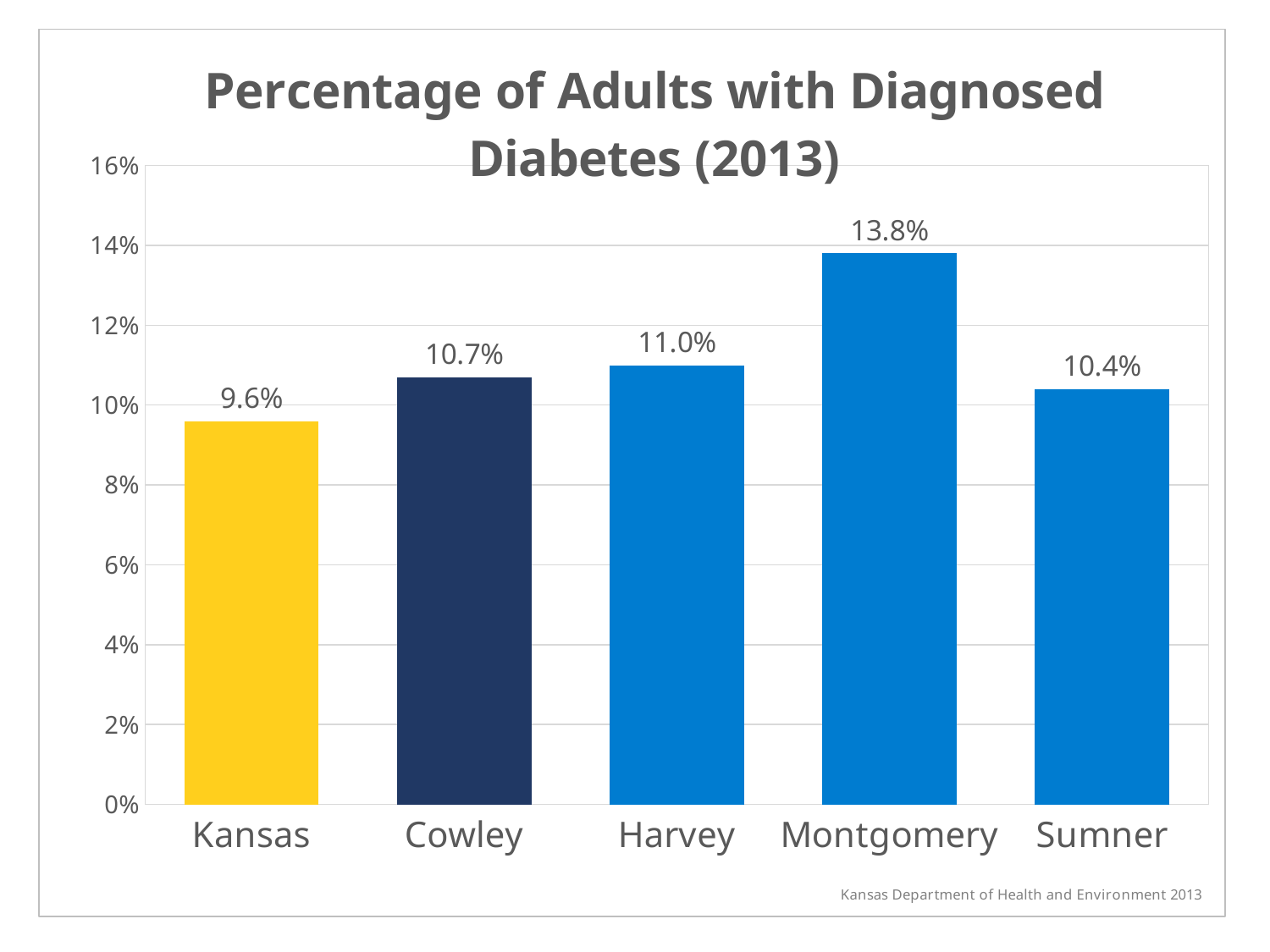
Which category has the highest percentage of adults with diagnosed diabetes? Montgomery What is the value shown for Kansas? 9.6% What kind of chart is shown on the slide? Bar chart What is the percentage of adults with diagnosed diabetes in Montgomery? 13.8% What is the difference between the values for Montgomery and Kansas? 4.2% What is the title of the chart? Percentage of Adults with Diagnosed Diabetes (2013) What is the value shown for Cowley? 10.7% What is the value shown for Sumner? 10.4% Which has a higher value, Harvey or Sumner? Harvey Which category has the lowest percentage of adults with diagnosed diabetes? Kansas How many categories are shown on the x axis? 5 Is the value for Montgomery greater or less than 12%? greater